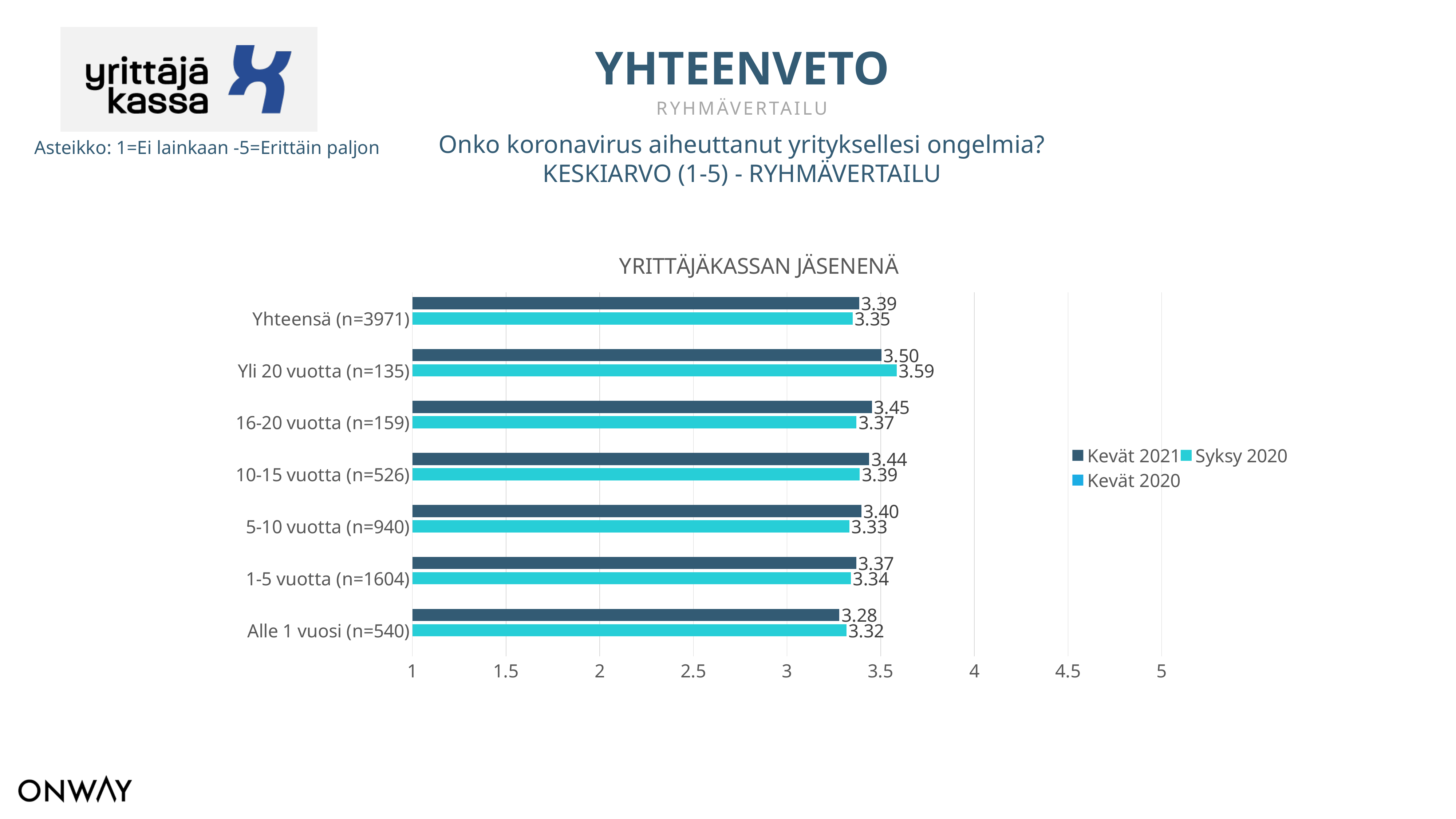
For 5-10 vuotta (n=940), which is larger: the Kevät 2021 value or the Syksy 2020 value? Kevät 2021 What is the Kevät 2021 value for Yli 20 vuotta (n=135)? 3.50 What kind of chart is shown on the slide? bar chart Which category has the highest Syksy 2020 value? Yli 20 vuotta (n=135) Is the Kevät 2021 value for Alle 1 vuosi (n=540) greater or less than 3.5? less What is the Kevät 2021 value for Yhteensä (n=3971)? 3.39 Which category has the lowest Kevät 2021 value? Alle 1 vuosi (n=540) How many series does the chart legend list? 3 What is the difference between the Kevät 2021 and Syksy 2020 values for 16-20 vuotta (n=159)? 0.08 What is the difference between the Syksy 2020 and Kevät 2021 values for Yli 20 vuotta (n=135)? 0.09 How many categories are shown on the y axis of the chart? 7 What is the Syksy 2020 value for Alle 1 vuosi (n=540)? 3.32